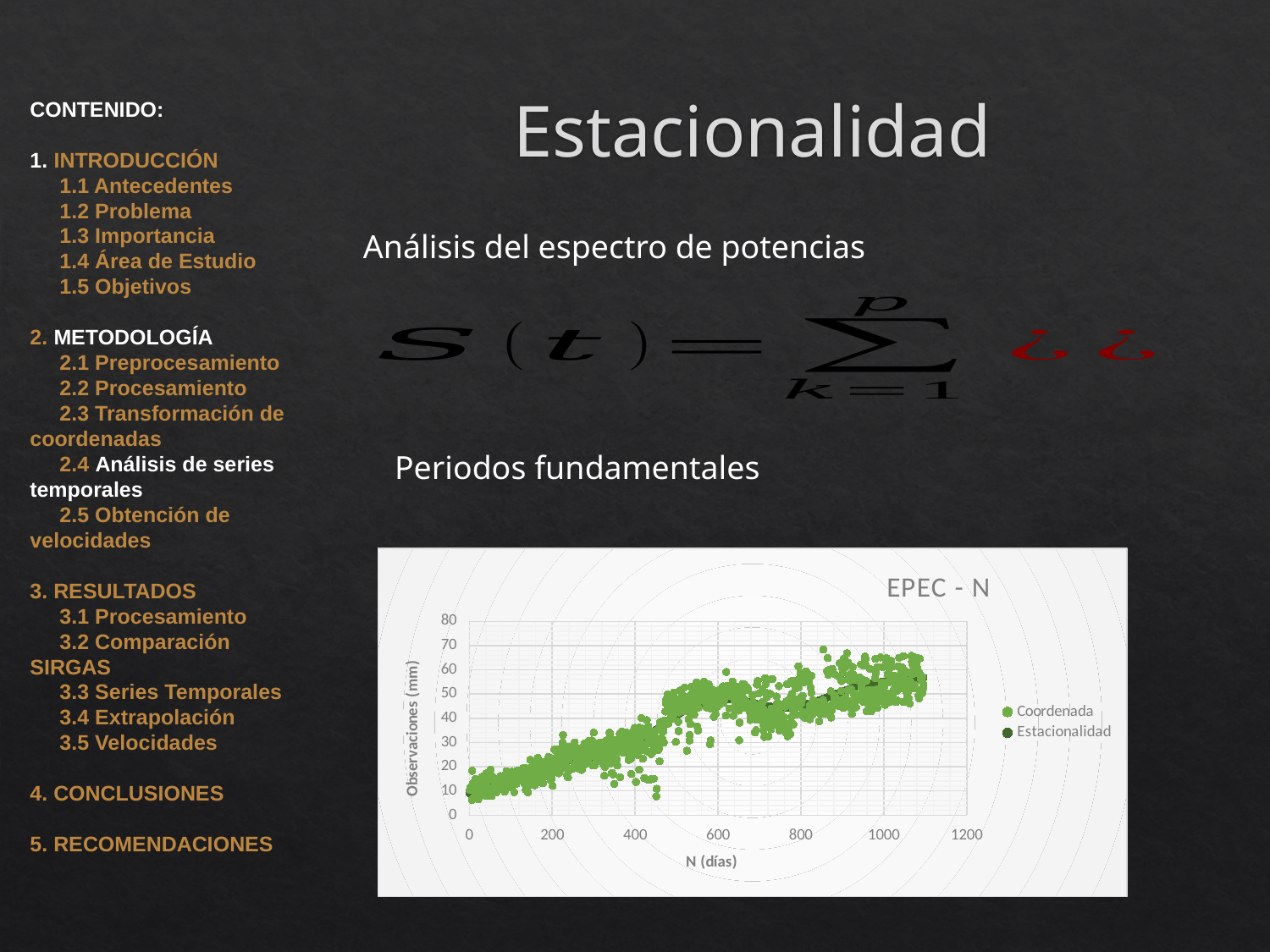
Do the plotted values rise or fall as N (días) increases along the x axis? rise Are the Coordenada values near N = 0 días greater or less than 20 mm? less What kind of chart is shown on the slide? scatter chart Are the values plotted near N = 1000 días larger or smaller than those near N = 200 días? larger What are the two series named in the chart legend? Coordenada and Estacionalidad What is the title of the chart? EPEC - N Are the Coordenada values near N = 1000 días greater or less than 40 mm? greater Are the Coordenada values near N = 600 días greater or less than 30 mm? greater What is the maximum value shown on the y axis of the chart? 80 How many series does the chart legend list? 2